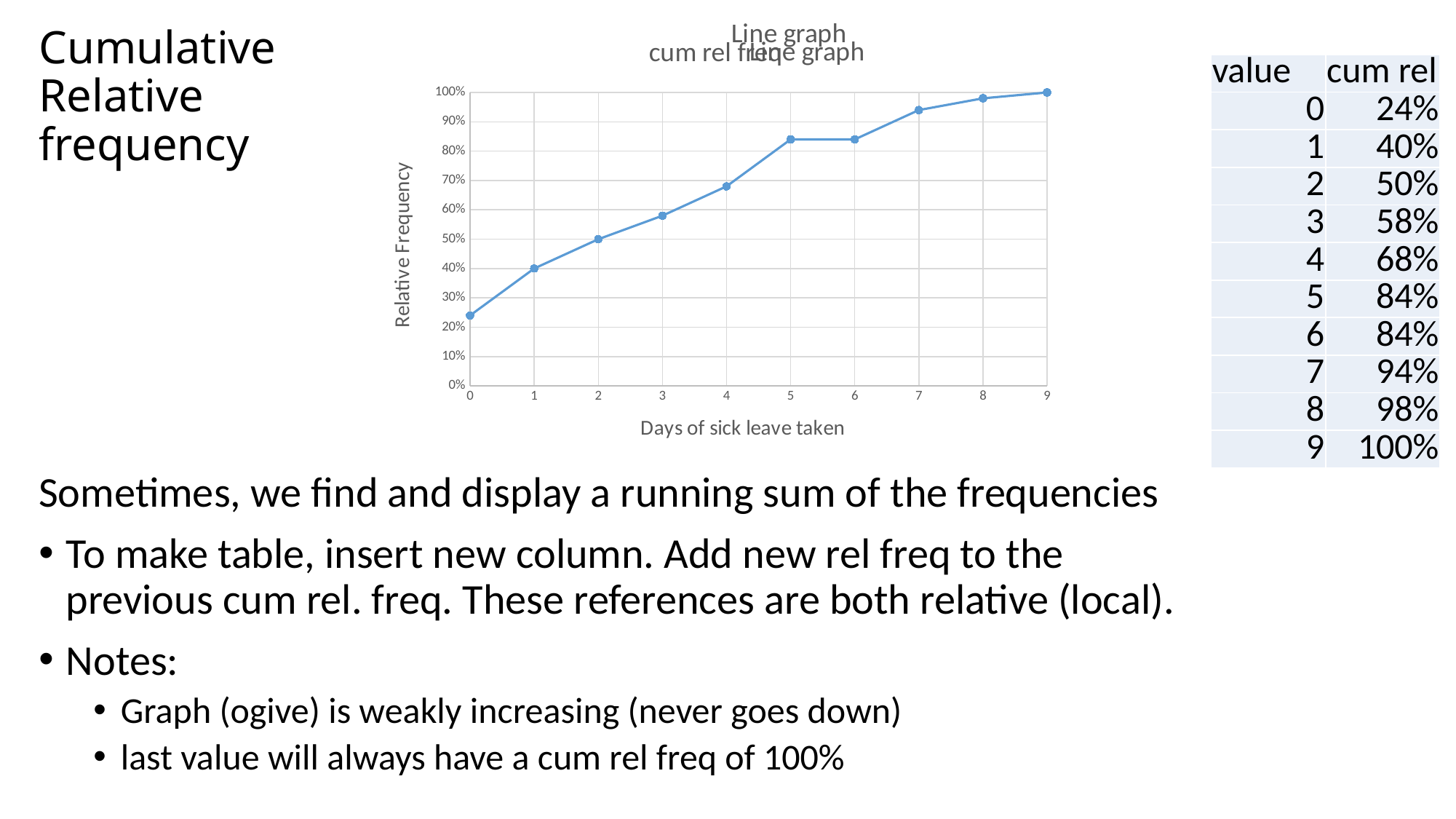
Which number of days of sick leave has the lowest plotted value? 0 Is the value plotted at 0 days of sick leave greater or less than 30%? less Is the value plotted at 5 days of sick leave greater or less than 80%? greater Do the plotted values rise or fall as the number of days of sick leave increases? rise What is the relative frequency value plotted at 1 day of sick leave taken? 40% What is the title of the x axis of the chart? Days of sick leave taken What is the relative frequency value plotted at 2 days of sick leave taken? 50% What is the relative frequency value plotted at 9 days of sick leave taken? 100% What kind of chart is shown on the slide? line chart Which is larger: the value plotted at 4 days or the value plotted at 7 days? 7 days How many data points are plotted on the line chart? 10 Which number of days of sick leave has the highest plotted value? 9